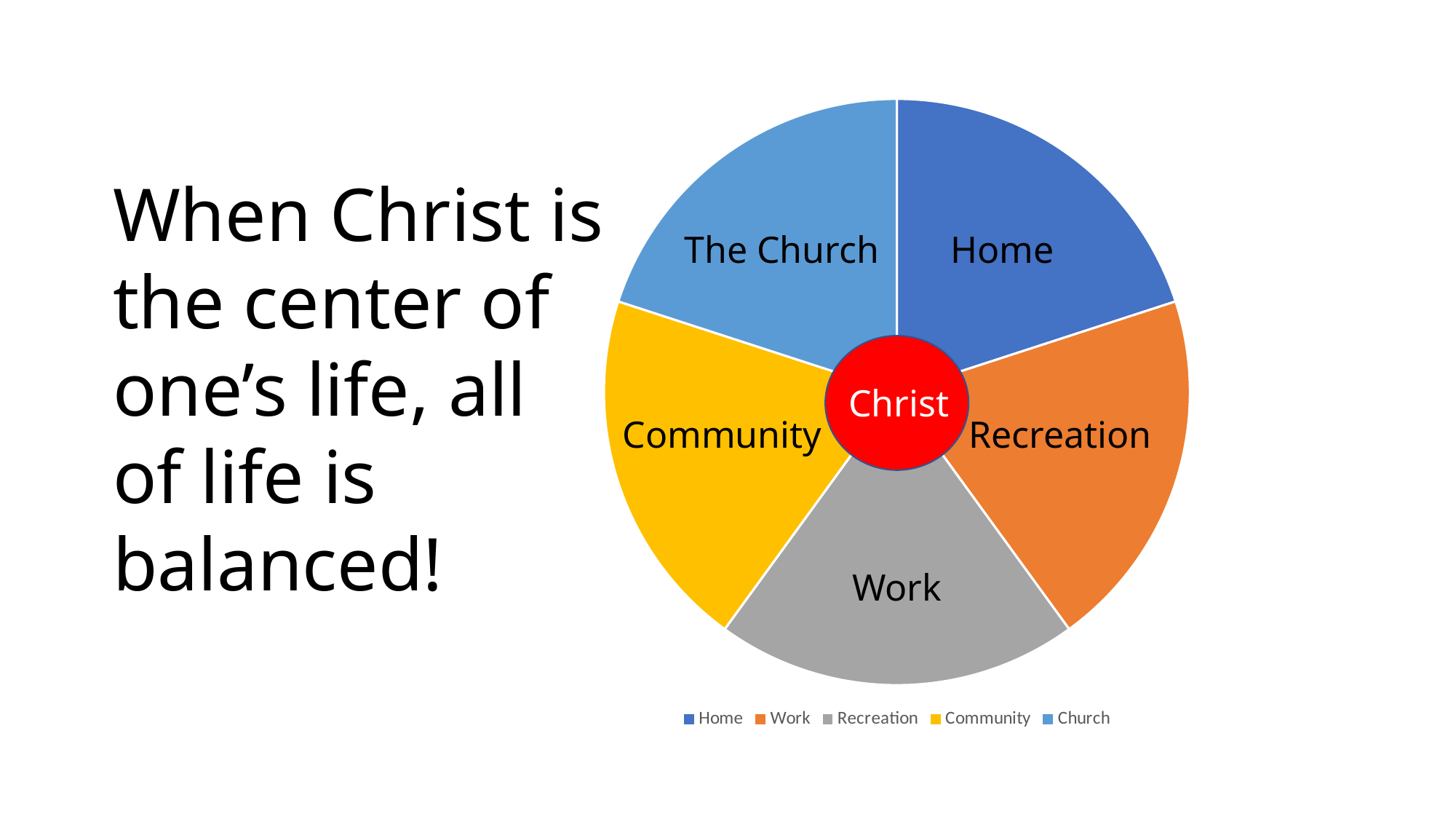
How many slices does the pie chart have? 5 What kind of chart is shown on the slide? pie chart What are the entries listed in the pie chart's legend, in order? Home, Work, Recreation, Community, Church How many entries does the legend of the pie chart list? 5 Are the five slices of the pie chart roughly equal in size? yes What word is written in the red circle at the center of the pie chart? Christ